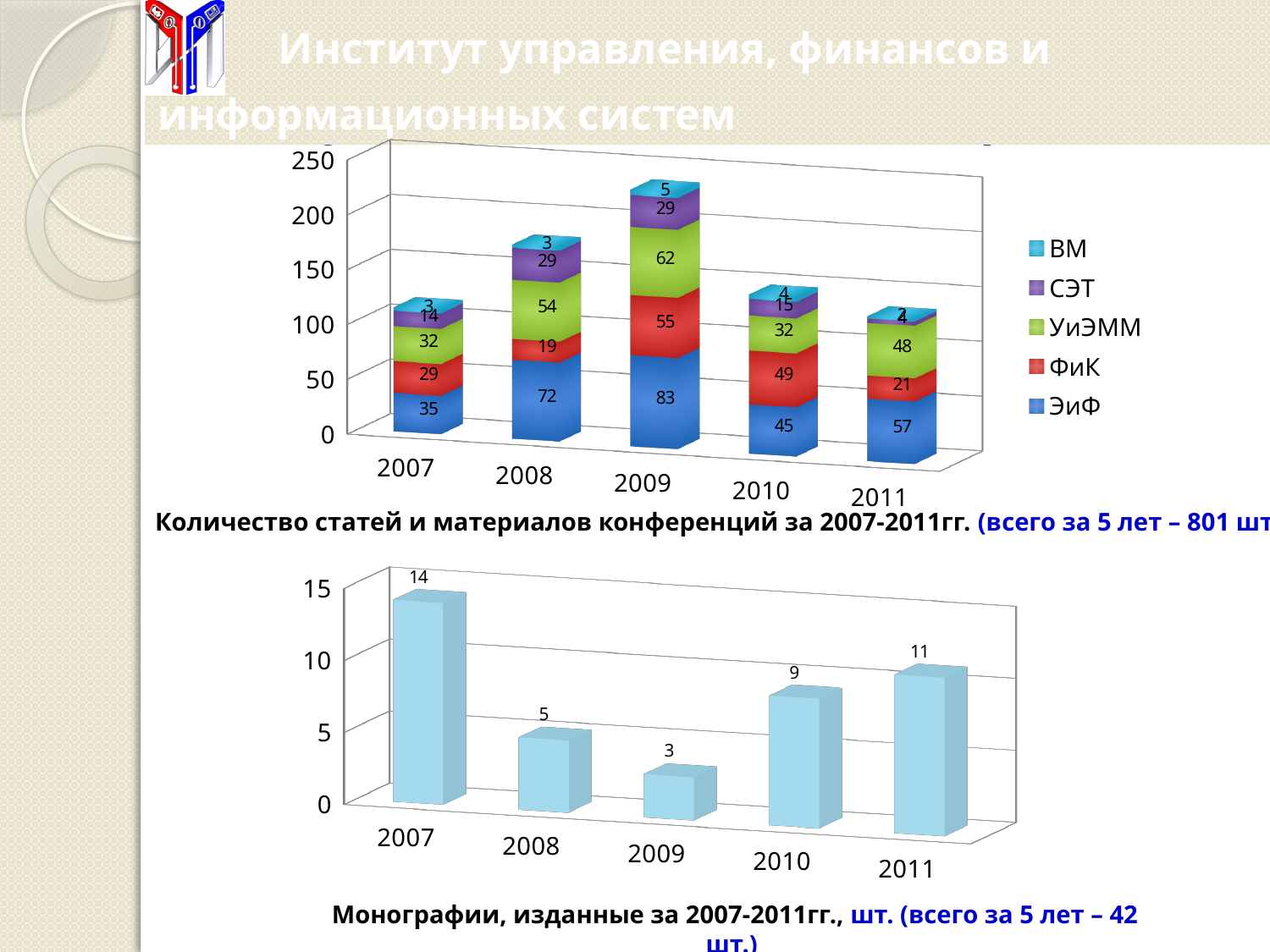
In the top chart (articles and conference materials), which year has the tallest stacked bar? 2009 In the top chart (articles and conference materials), what is the value for УиЭММ in 2008? 54 In the top chart (articles and conference materials), is the ЭиФ value for 2008 larger or smaller than the ЭиФ value for 2010? larger In the top chart (articles and conference materials), what is the total of the stacked bar for 2009? 234 In the bottom chart (monographs), what is the difference between the values for 2011 and 2010? 2 In the bottom chart (monographs), how many years are shown on the x axis? 5 In the top chart (articles and conference materials), how many series does the legend list? 5 In the top chart (articles and conference materials), what is the value for ФиК in 2010? 49 In the top chart (articles and conference materials), what is the value for ЭиФ in 2009? 83 What kind of chart is the bottom chart (monographs)? bar chart In the bottom chart (monographs), what is the value for 2007? 14 In the bottom chart (monographs), which year has the lowest value? 2009